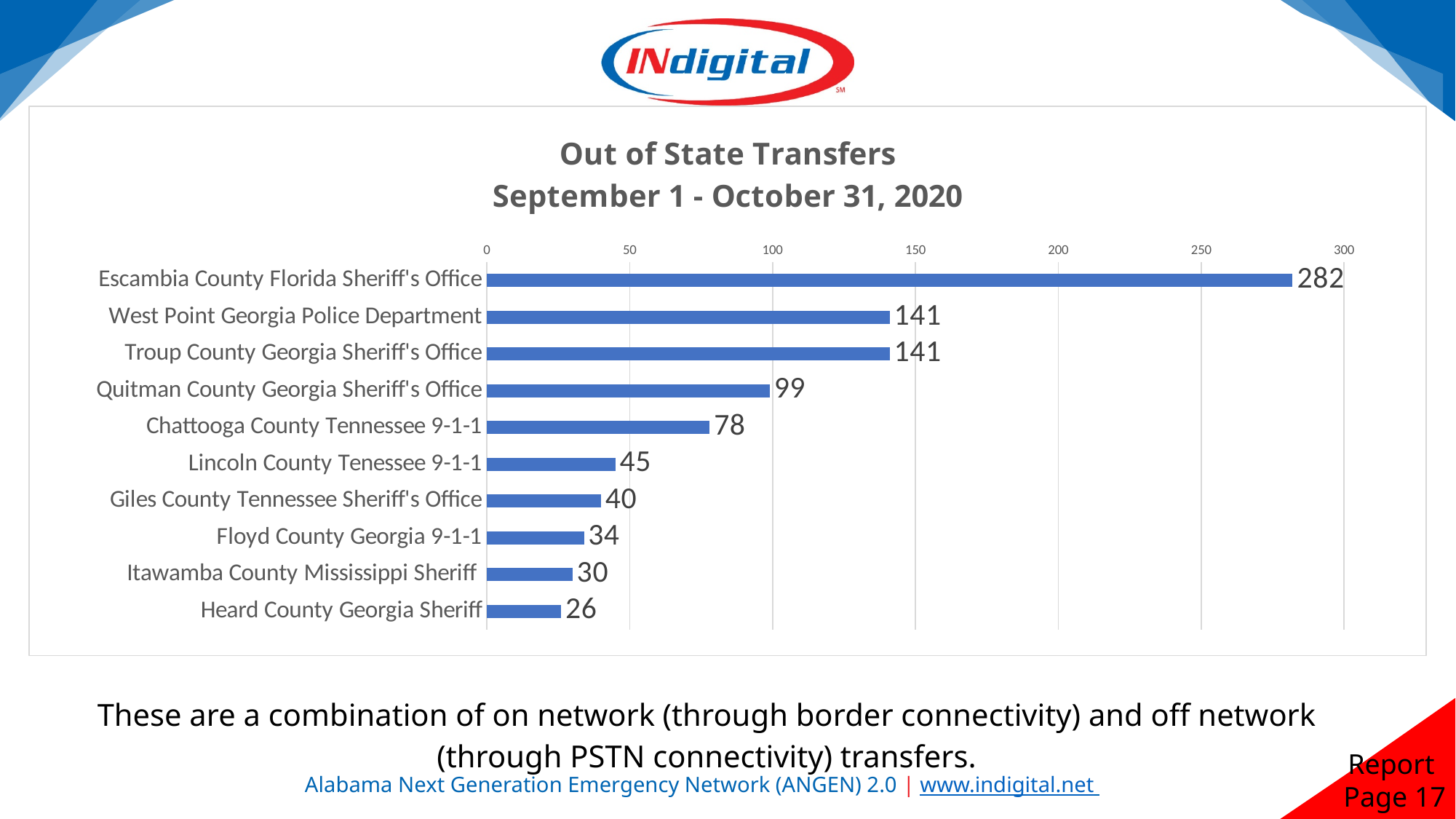
What is the difference between the values for Lincoln County Tenessee 9-1-1 and Giles County Tennessee Sheriff's Office? 5 How many out of state transfers did Escambia County Florida Sheriff's Office receive? 282 Which agency has the lowest number of out of state transfers? Heard County Georgia Sheriff What kind of chart is shown on the slide? bar chart Which is larger, the value for Floyd County Georgia 9-1-1 or Itawamba County Mississippi Sheriff? Floyd County Georgia 9-1-1 What is the value for Quitman County Georgia Sheriff's Office? 99 Is the value for Quitman County Georgia Sheriff's Office greater or less than 100? less What is the value for Chattooga County Tennessee 9-1-1? 78 What is the difference between the values for Escambia County Florida Sheriff's Office and West Point Georgia Police Department? 141 How many agencies are shown in the chart? 10 What date range does the chart title cover? September 1 - October 31, 2020 Which agency has the highest number of out of state transfers? Escambia County Florida Sheriff's Office